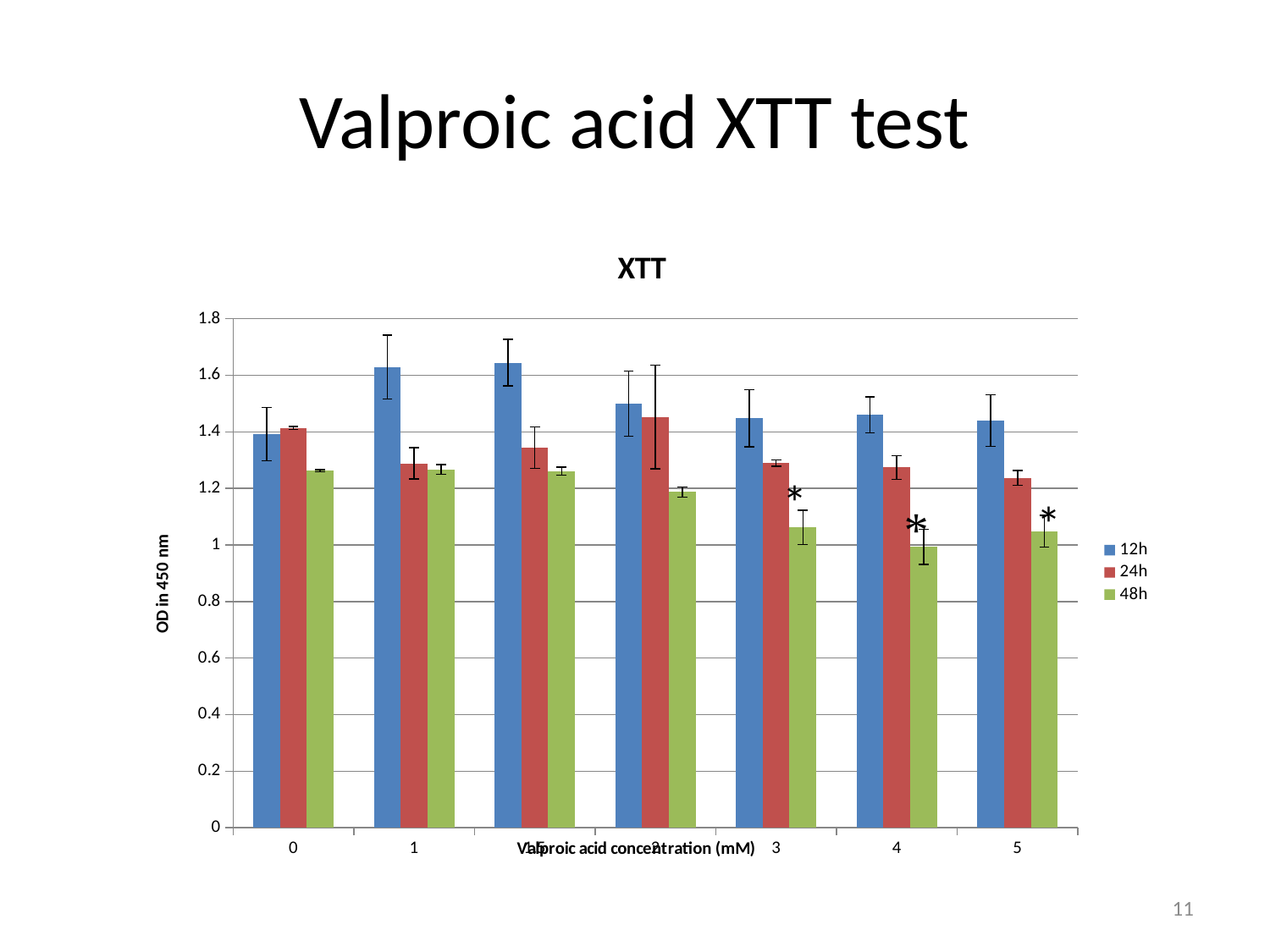
Is the 24h value at 3 mM greater or less than 1.2? greater How many series does the legend list? 3 At 5 mM, which is larger, the 24h value or the 48h value? 24h Do the 48h values generally rise or fall as the valproic acid concentration increases? fall What kind of chart is shown on the slide? bar chart How many concentration groups of bars are plotted? 7 Is the 48h value at 5 mM greater or less than 1.2? less At 3 mM, which series has the highest value? 12h Is the 12h value at 1 mM greater or less than 1.4? greater What are the legend entries of the chart? 12h, 24h, 48h What is the title of the chart? XTT At 0 mM, which is larger, the 12h value or the 48h value? 12h